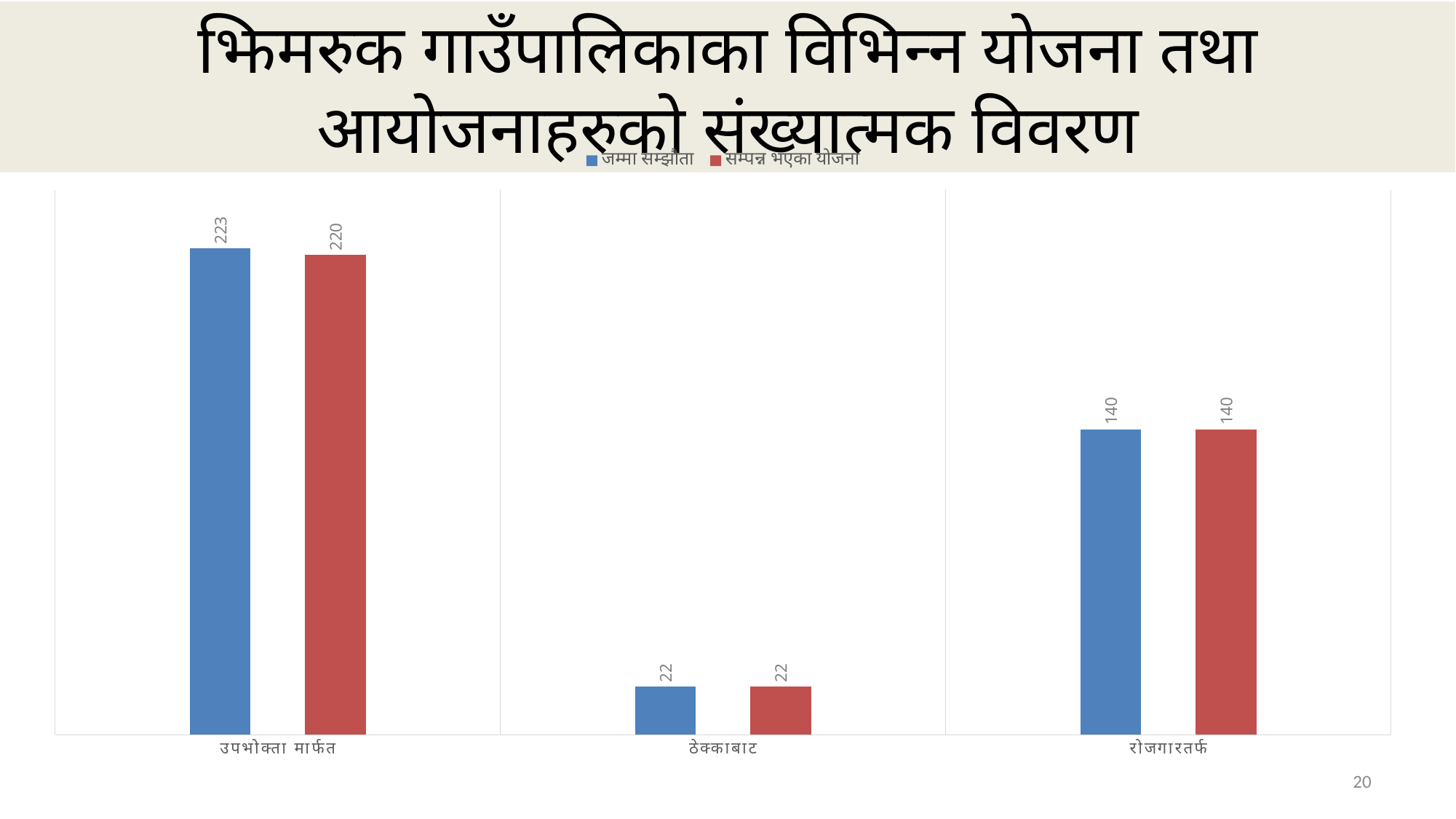
How many series does the chart's legend list? 2 Which category has the lowest value for सम्पन्न भएका योजना? ठेक्काबाट Which colour represents the जम्मा सम्झौता series in the chart? blue Which category has the highest value for जम्मा सम्झौता? उपभोक्ता मार्फत What type of chart is shown on the slide? bar chart What is the difference between जम्मा सम्झौता and सम्पन्न भएका योजना for उपभोक्ता मार्फत? 3 What is the value of सम्पन्न भएका योजना for उपभोक्ता मार्फत? 220 What is the value of सम्पन्न भएका योजना for रोजगारतर्फ? 140 What is the value of जम्मा सम्झौता for उपभोक्ता मार्फत? 223 Which is larger: जम्मा सम्झौता for रोजगारतर्फ or जम्मा सम्झौता for ठेक्काबाट? रोजगारतर्फ What is the value of जम्मा सम्झौता for ठेक्काबाट? 22 How many categories are shown on the x axis of the chart? 3